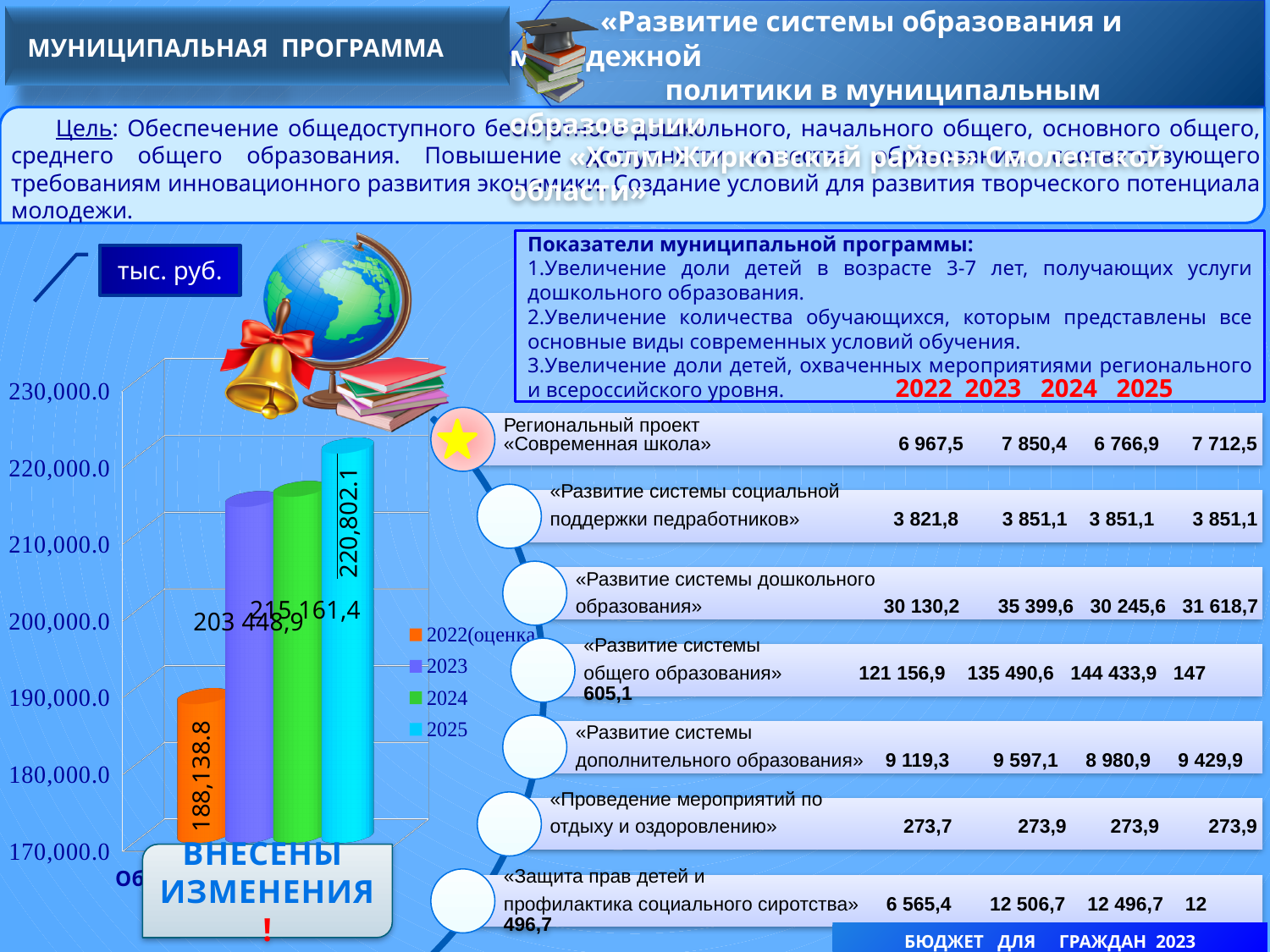
What is the value shown for 2022(оценка) in the bar chart? 188,138.8 Which year has the lowest bar in the chart? 2022(оценка) Which is larger, the value for 2023 or the value for 2024? 2024 What is the value shown for 2024 in the bar chart? 215 161,4 What is the value shown for 2025 in the bar chart? 220,802.1 What unit is indicated in the box above the bar chart? тыс. руб. How many series does the legend of the bar chart list? 4 Which year has the highest bar in the chart? 2025 What type of chart is shown on the left of the slide? bar chart Do the bar values rise or fall from 2022(оценка) to 2025? rise Is the value for 2022(оценка) greater or less than 190,000.0? less